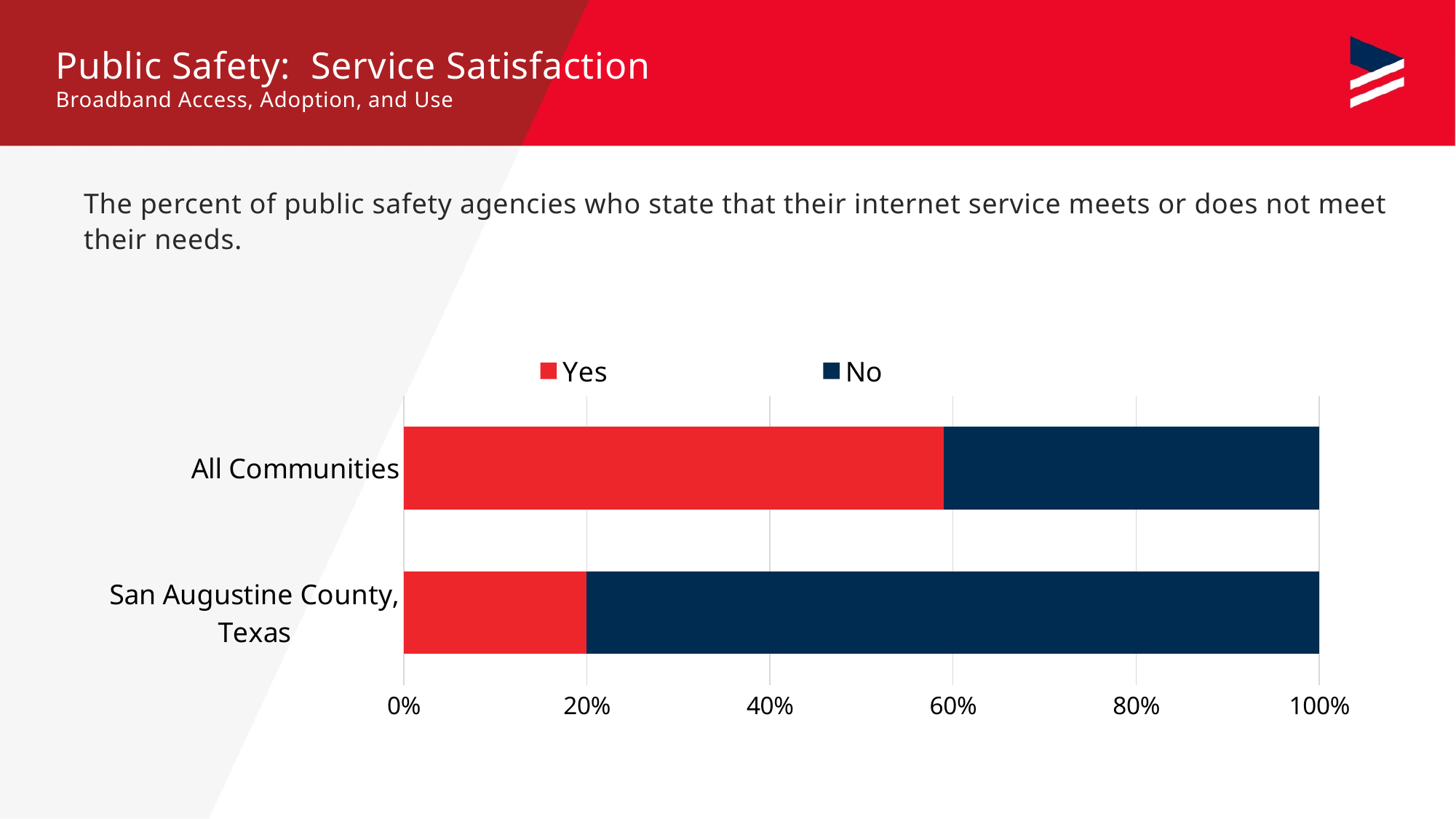
Which colour represents the "No" series? dark navy blue Which category has the highest "No" value? San Augustine County, Texas How many series does the legend list? 2 Is the "No" value for All Communities greater or less than 60%? less Is the "Yes" value for All Communities greater or less than 40%? greater What is the total of the stacked bar for San Augustine County, Texas? 100% What kind of chart is shown on the slide? bar chart Which category has the larger "Yes" share, All Communities or San Augustine County, Texas? All Communities What is the "Yes" value for San Augustine County, Texas? 20% How many categories are plotted on the chart? 2 What are the two series named in the legend? Yes and No Is the "No" value for San Augustine County, Texas greater or less than 60%? greater